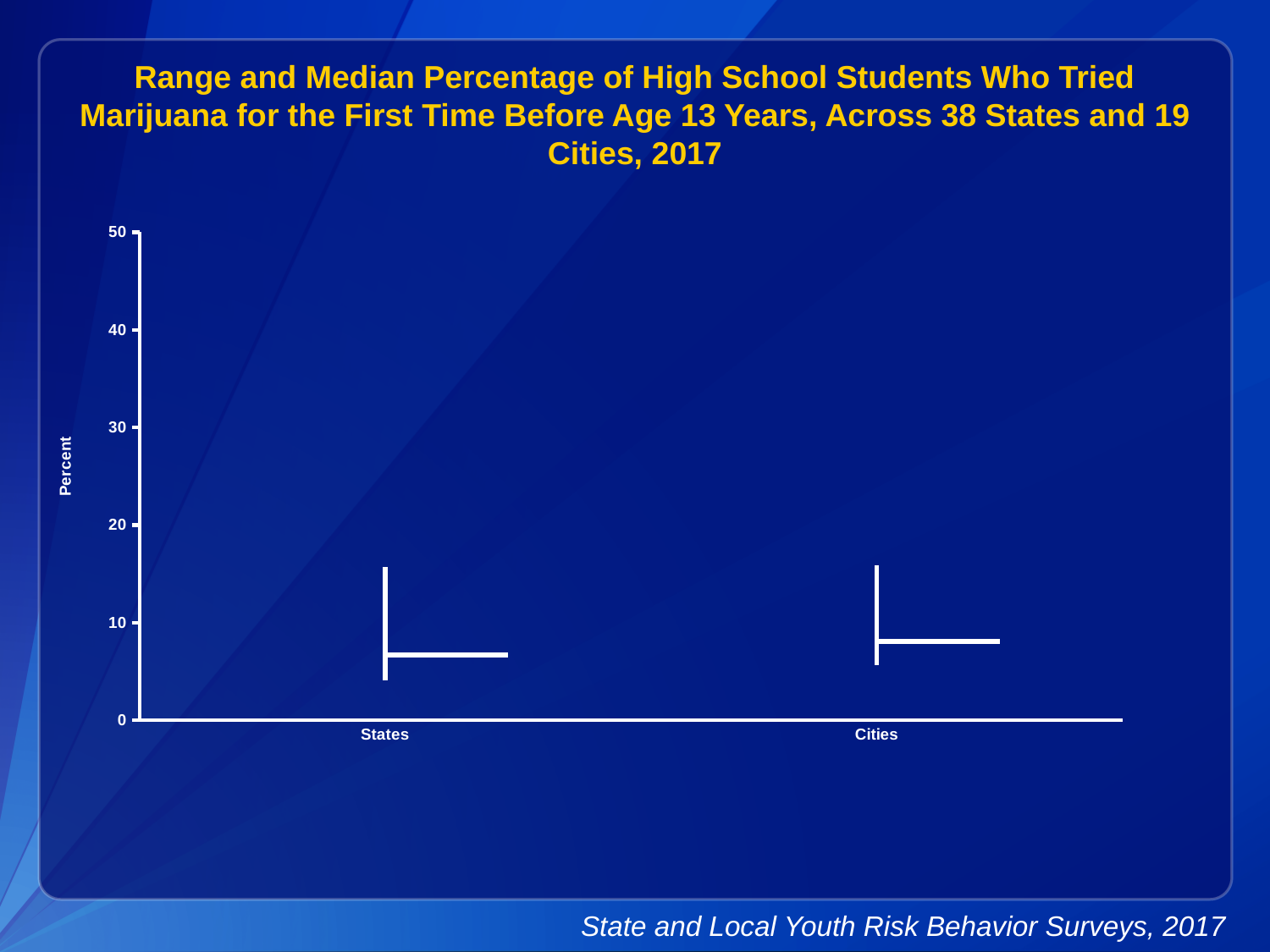
How many categories are shown on the x axis of the chart? 2 Is the top of the range for States greater or less than 10? greater What are the two categories shown on the x axis? States and Cities Is the top of the range for States greater or less than 20? less Is the median value for Cities greater or less than 10? less What is the highest value shown on the y axis? 50 What is the label of the y axis? Percent